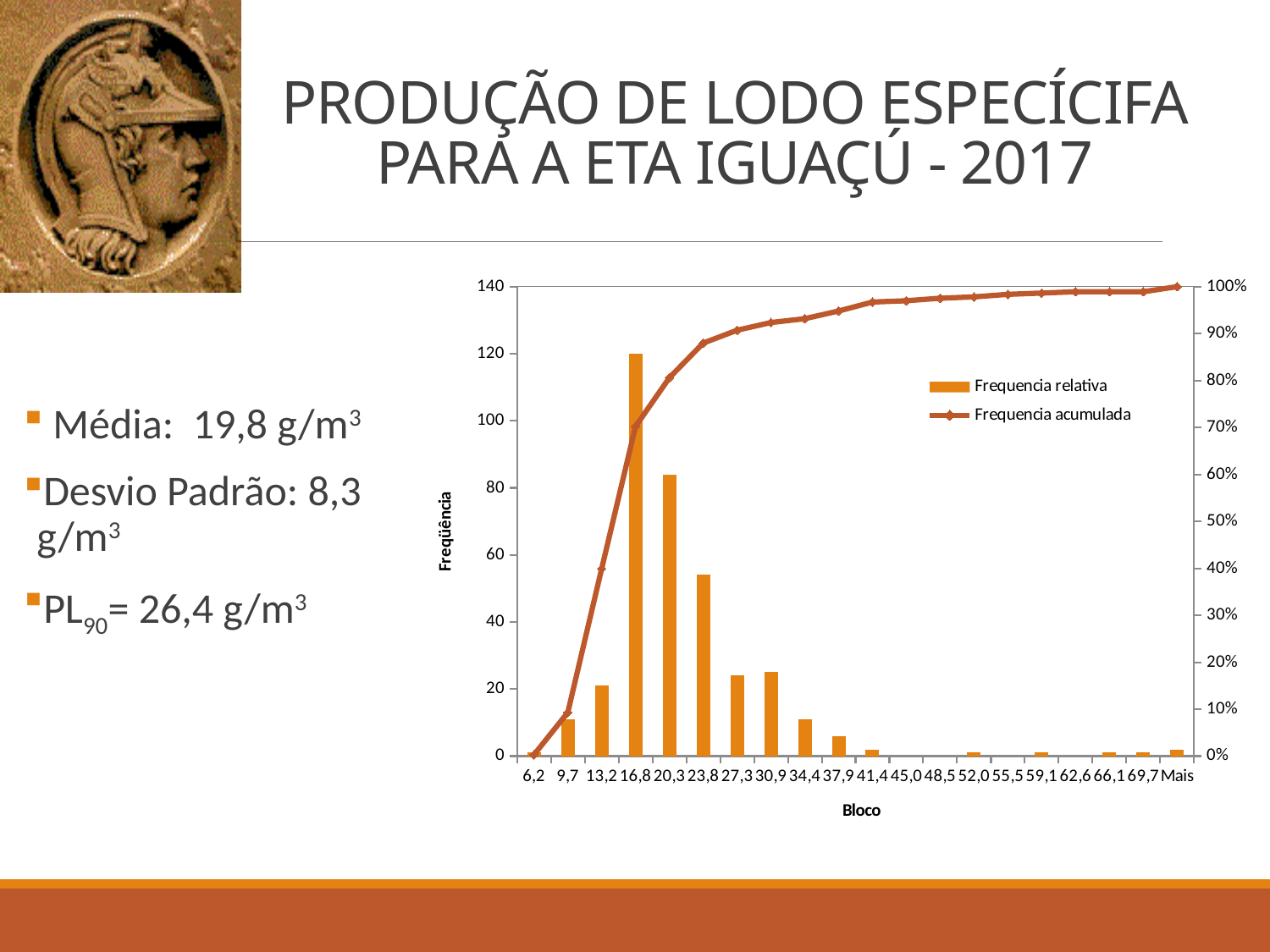
How many categories are shown on the x axis (Bloco)? 20 Does the Frequencia acumulada line rise or fall along the x axis? It rises Which has a larger Frequencia relativa, Bloco 20,3 or Bloco 23,8? 20,3 Is the Frequencia relativa value for Bloco 34,4 greater or less than 20? less How many series does the chart legend list? 2 Is the Frequencia relativa value for Bloco 20,3 greater or less than 60? greater What is the title of the x axis of the chart? Bloco What kind of chart is shown on the slide? A combined bar and line chart Is the Frequencia relativa value for Bloco 16,8 greater or less than 100? greater Which category (Bloco) has the highest Frequencia relativa bar? 16,8 What is the Frequencia acumulada value at the last category, Mais? 100%